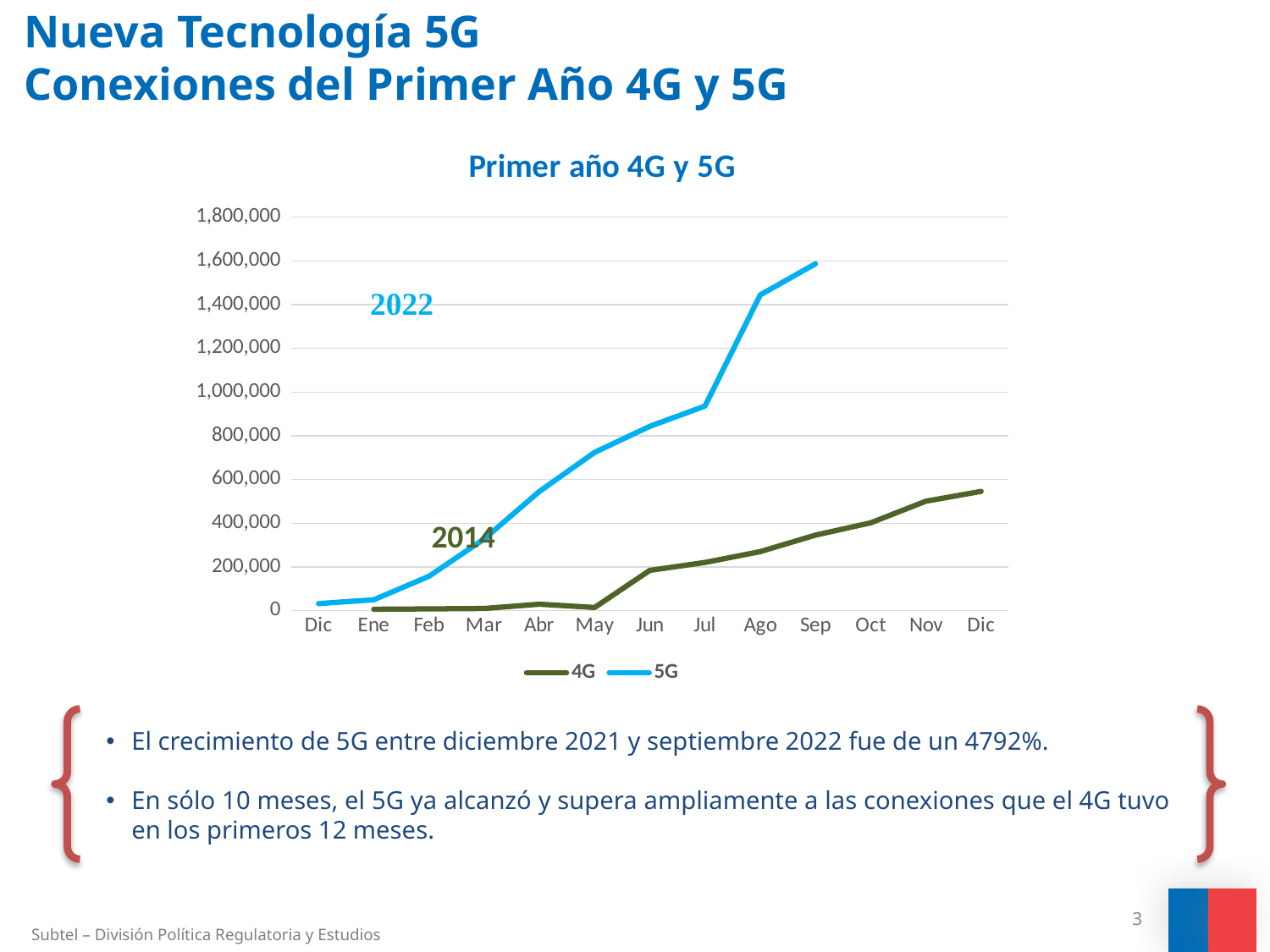
Is the value for 4G in the final Dic greater or less than 400,000? greater How many month categories are shown on the x axis of the chart? 13 In which month does the 5G series reach its highest value? Sep What kind of chart is shown on the slide? line chart Which is larger: the 5G value in Sep or the 4G value in the final Dic? 5G in Sep What is the title of the chart? Primer año 4G y 5G Do the 5G values rise or fall from Dic to Sep? rise Is the value for 5G in Jul greater or less than 800,000? greater Which series is drawn in light blue in the chart? 5G How many series does the chart legend list? 2 In which month does the 5G series have its lowest value? Dic (the first one) Is the value for 5G in Sep greater or less than 1,400,000? greater